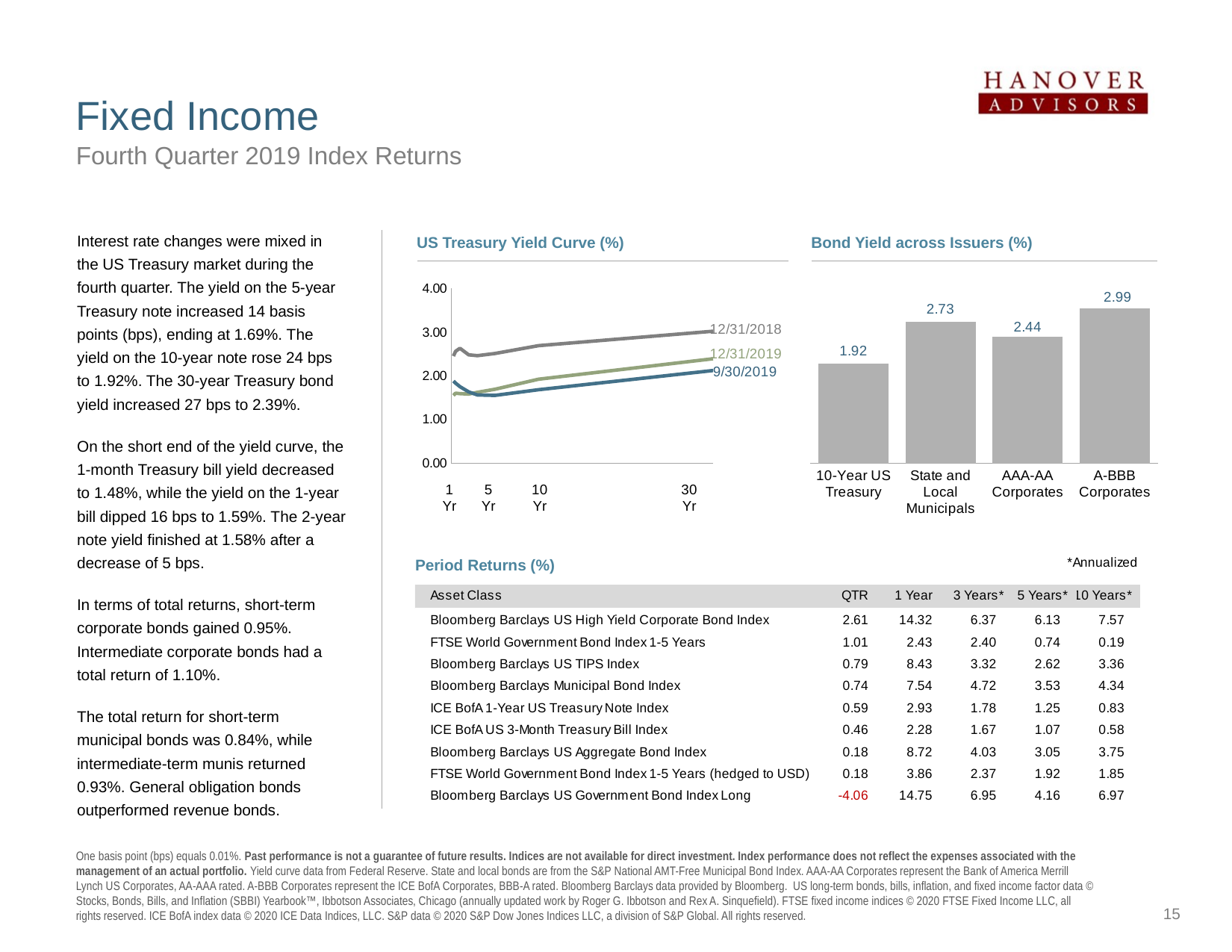
In the Bond Yield across Issuers (%) chart, which is larger: State and Local Municipals or AAA-AA Corporates? State and Local Municipals How many categories are shown in the Bond Yield across Issuers (%) chart? 4 In the US Treasury Yield Curve (%) chart, does the 12/31/2019 series rise or fall from 5 Yr to 30 Yr? rise In the Bond Yield across Issuers (%) chart, what is the value for 10-Year US Treasury? 1.92 In the Bond Yield across Issuers (%) chart, which category has the lowest value? 10-Year US Treasury In the Bond Yield across Issuers (%) chart, what is the value for AAA-AA Corporates? 2.44 In the Bond Yield across Issuers (%) chart, which category has the highest value? A-BBB Corporates What kind of chart is the Bond Yield across Issuers (%) chart? Bar chart How many series are shown in the US Treasury Yield Curve (%) chart? 3 In the Bond Yield across Issuers (%) chart, what is the difference between A-BBB Corporates and 10-Year US Treasury? 1.07 In the US Treasury Yield Curve (%) chart, is the value of the 12/31/2018 series at 1 Yr greater or less than 2.00? greater In the Bond Yield across Issuers (%) chart, what is the value for State and Local Municipals? 2.73